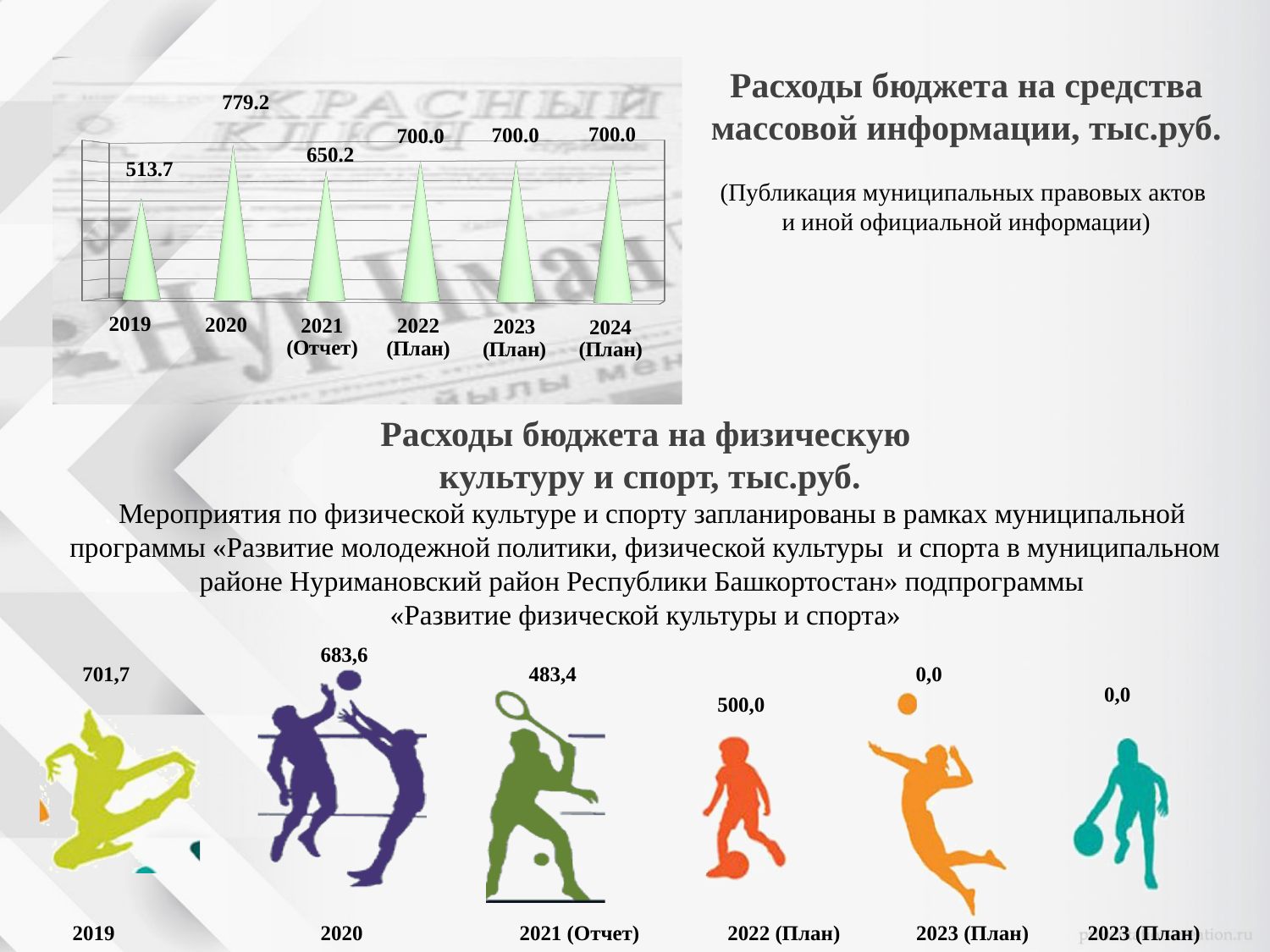
In the infographic 'Расходы бюджета на физическую культуру и спорт, тыс.руб.' at the bottom of the slide, what is the value for 2021 (Отчет)? 483,4 In the chart 'Расходы бюджета на средства массовой информации, тыс.руб.', which year has the lowest value? 2019 In the chart 'Расходы бюджета на средства массовой информации, тыс.руб.', what is the difference between the 2020 value and the 2019 value? 265.5 How many years (categories) are shown in the chart 'Расходы бюджета на средства массовой информации, тыс.руб.'? 6 In the chart 'Расходы бюджета на средства массовой информации, тыс.руб.', what is the value for 2020? 779.2 In the chart 'Расходы бюджета на средства массовой информации, тыс.руб.', which is larger: the value for 2021 (Отчет) or the value for 2022 (План)? 2022 (План) In the chart 'Расходы бюджета на средства массовой информации, тыс.руб.', what is the value for 2021 (Отчет)? 650.2 In the chart 'Расходы бюджета на средства массовой информации, тыс.руб.', which year has the highest value? 2020 In the chart 'Расходы бюджета на средства массовой информации, тыс.руб.', what is the value for 2024 (План)? 700.0 In the chart 'Расходы бюджета на средства массовой информации, тыс.руб.', what is the difference between the 2020 value and the 2021 (Отчет) value? 129.0 In the chart 'Расходы бюджета на средства массовой информации, тыс.руб.', do the values for 2022, 2023 and 2024 (План) change or stay the same? stay the same In the chart 'Расходы бюджета на средства массовой информации, тыс.руб.', what is the value for 2019? 513.7